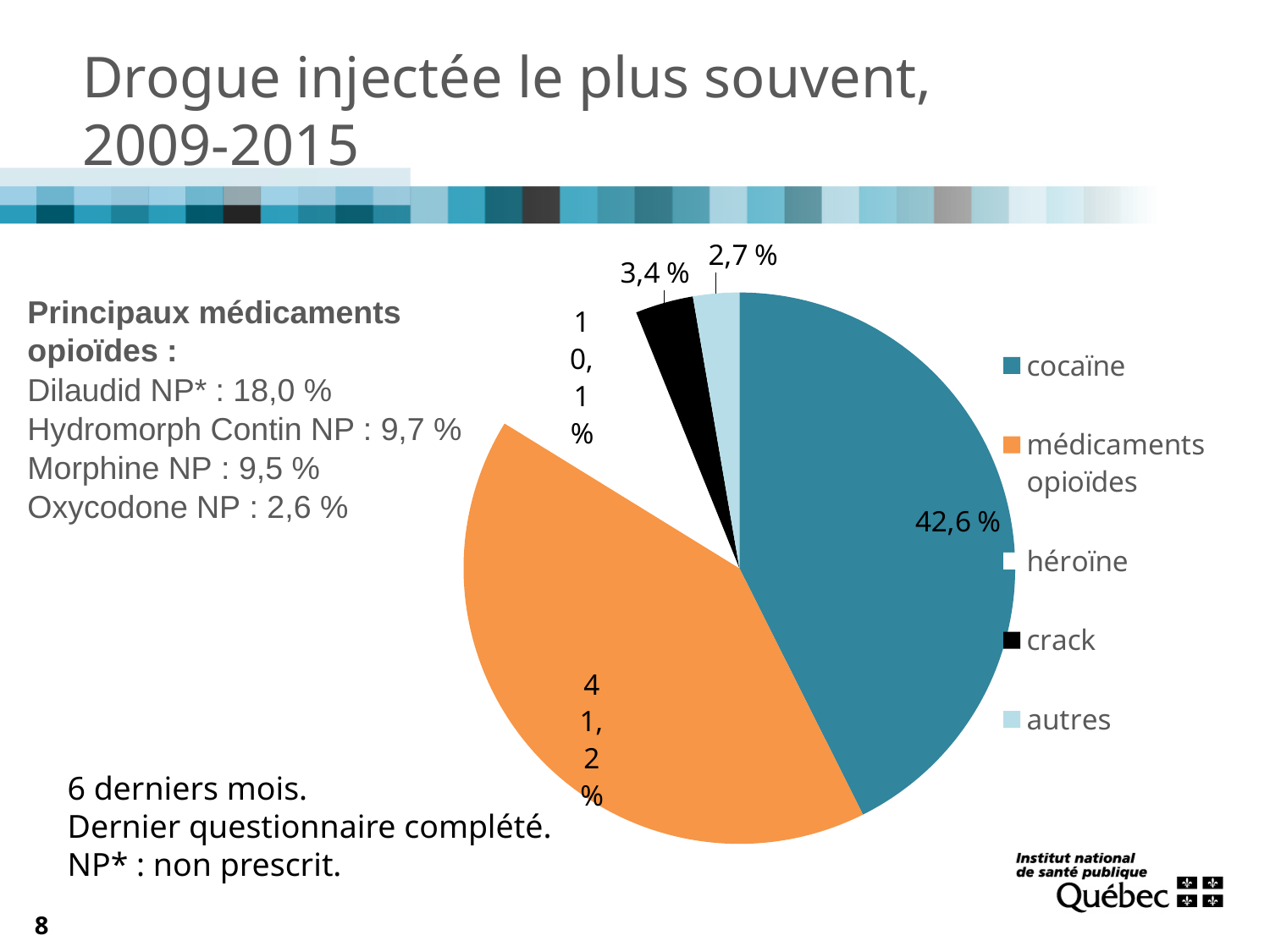
Which is larger, the share for héroïne or the share for crack? héroïne What percentage of the pie is crack? 3,4 % What type of chart is shown on the slide? pie chart What is the title of the chart on the slide? Drogue injectée le plus souvent, 2009-2015 How many categories does the legend list? 5 What percentage of the pie is médicaments opioïdes? 41,2 % What percentage of the pie is cocaïne? 42,6 % Which category has the largest share of the pie? cocaïne What percentage of the pie is autres? 2,7 % What percentage of the pie is héroïne? 10,1 % What is the difference in percentage points between cocaïne and médicaments opioïdes? 1,4 Which category has the smallest share of the pie? autres